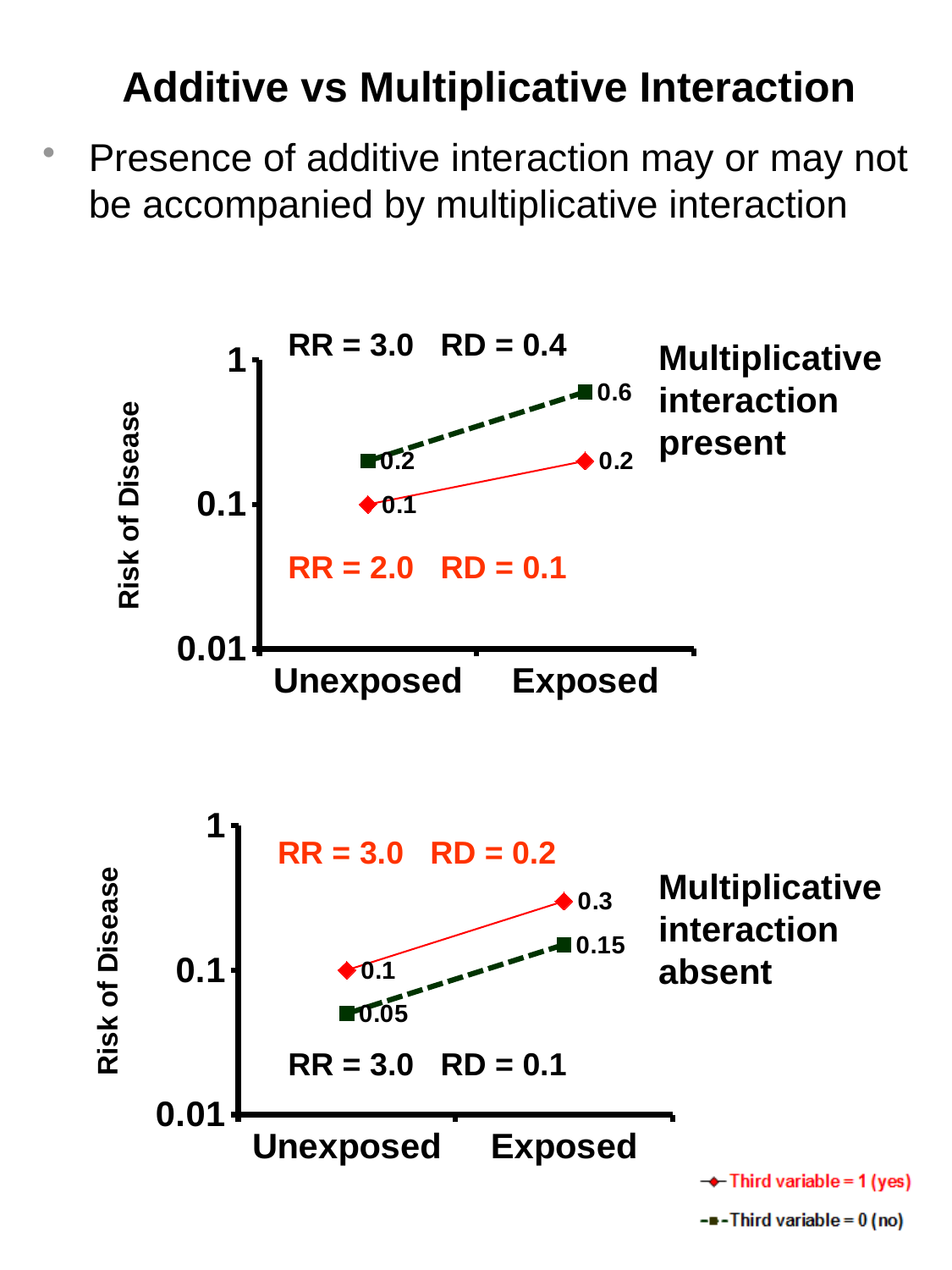
In the bottom chart (multiplicative interaction absent), what is the risk of disease for the Exposed group in the 'Third variable = 1 (yes)' series? 0.3 What kind of chart is the top chart? line chart In the bottom chart, what is the difference in risk between Exposed and Unexposed for the 'Third variable = 1 (yes)' series? 0.2 In the bottom chart, which series has the higher risk for the Unexposed group, 'Third variable = 1 (yes)' or 'Third variable = 0 (no)'? Third variable = 1 (yes) In the top chart, which series has the higher risk for the Exposed group, 'Third variable = 1 (yes)' or 'Third variable = 0 (no)'? Third variable = 0 (no) In the bottom chart, does the risk of disease rise or fall from Unexposed to Exposed for the 'Third variable = 0 (no)' series? rise How many series does the legend list for the charts? 2 In the top chart (multiplicative interaction present), what is the risk of disease for the Unexposed group in the 'Third variable = 1 (yes)' series? 0.1 In the top chart, what is the difference in risk between Exposed and Unexposed for the 'Third variable = 0 (no)' series? 0.4 In the top chart (multiplicative interaction present), what is the risk of disease for the Exposed group in the 'Third variable = 0 (no)' series? 0.6 In the bottom chart (multiplicative interaction absent), what is the risk of disease for the Unexposed group in the 'Third variable = 0 (no)' series? 0.05 How many categories are shown on the x axis of the bottom chart? 2